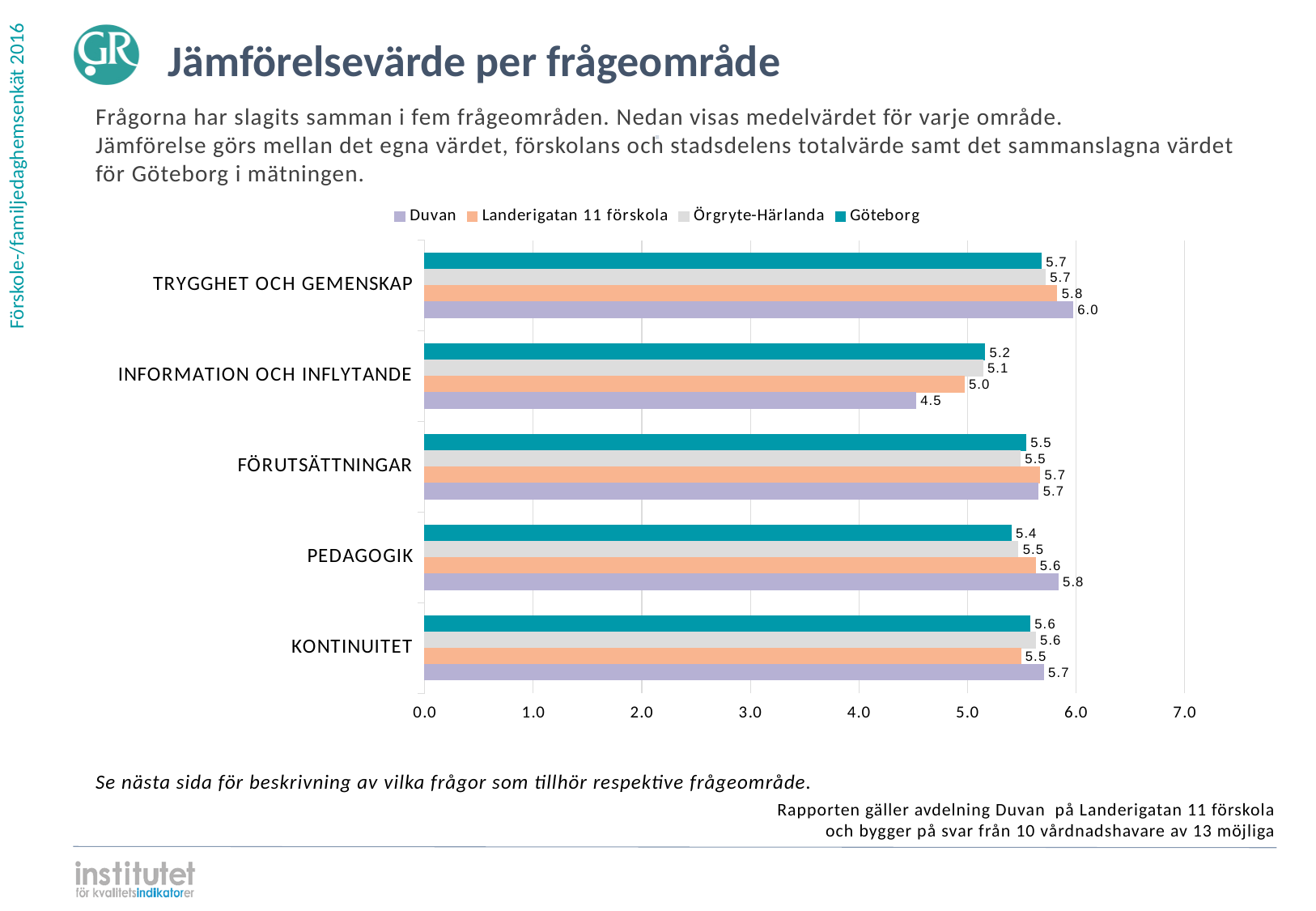
In the PEDAGOGIK category, which is larger: the Duvan value or the Göteborg value? Duvan In which category does Duvan have its lowest value? INFORMATION OCH INFLYTANDE In which category does Duvan have its highest value? TRYGGHET OCH GEMENSKAP Is the Duvan value for INFORMATION OCH INFLYTANDE greater or less than 5.0? less What is the value for Göteborg in the INFORMATION OCH INFLYTANDE category? 5.2 What is the value for Duvan in the TRYGGHET OCH GEMENSKAP category? 6.0 How many question areas (categories) are shown on the chart? 5 How many series does the legend list? 4 What kind of chart is shown on the slide? Bar chart Which series is shown in teal in the legend? Göteborg What is the difference between the Göteborg value and the Duvan value in the INFORMATION OCH INFLYTANDE category? 0.7 What is the value for Landerigatan 11 förskola in the PEDAGOGIK category? 5.6